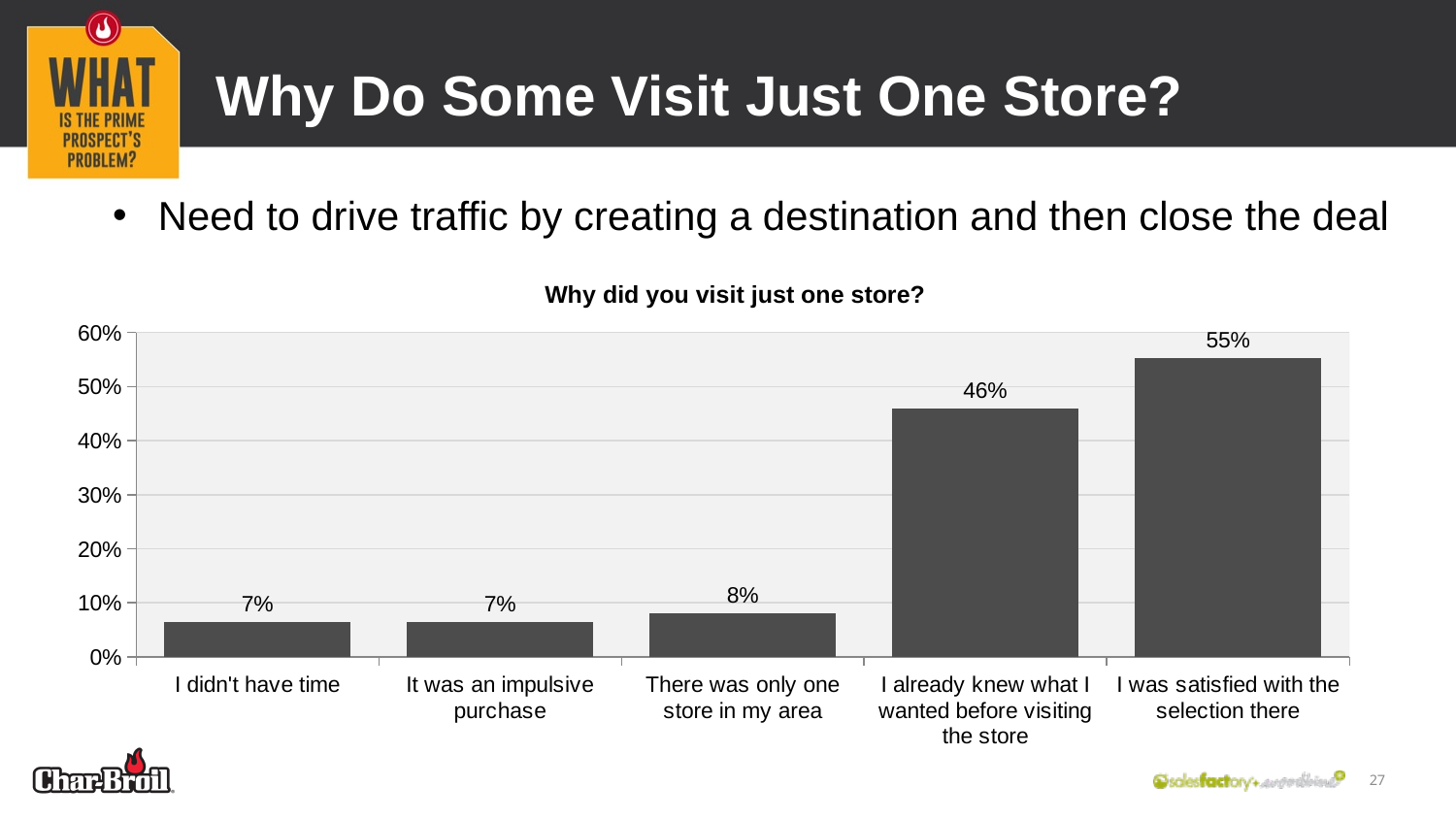
Is the value for "I already knew what I wanted before visiting the store" greater or less than 40%? greater What is the title of the chart? Why did you visit just one store? Which is larger: the value for "There was only one store in my area" or the value for "It was an impulsive purchase"? There was only one store in my area Which reason has the highest percentage? I was satisfied with the selection there What is the difference in percentage points between "I was satisfied with the selection there" and "I already knew what I wanted before visiting the store"? 9 percentage points What percentage of respondents said "I already knew what I wanted before visiting the store"? 46% How many reasons (categories) are shown in the chart? 5 What is the highest value shown on the vertical axis? 60% What percentage of respondents said "I didn't have time"? 7% What kind of chart is shown on the slide? Bar chart What percentage of respondents said "There was only one store in my area"? 8% What percentage of respondents said "I was satisfied with the selection there"? 55%